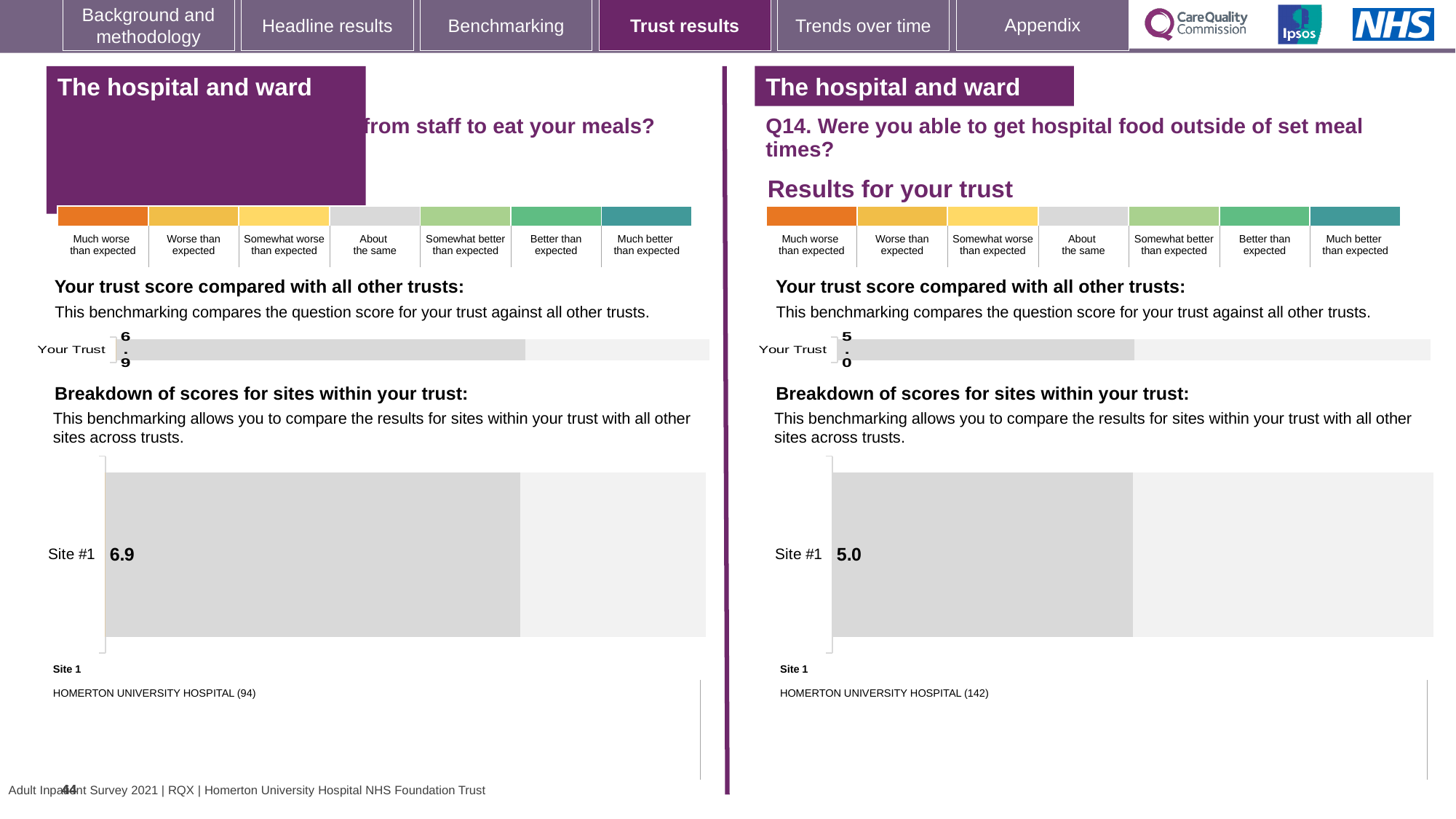
On the right-hand chart for Q14 (hospital food outside of set meal times), what is the score shown for Your Trust? 5.0 How many sites are shown in the right-hand 'Breakdown of scores for sites within your trust' chart for Q14? 1 How many sites are shown in the left-hand 'Breakdown of scores for sites within your trust' chart? 1 Which is larger: the Your Trust score on the left-hand chart or the Your Trust score on the right-hand Q14 chart? The left-hand chart (6.9) In the left-hand 'Breakdown of scores for sites within your trust' chart, what is the score for Site #1? 6.9 Which hospital is listed as Site 1 beneath the left-hand site breakdown chart? HOMERTON UNIVERSITY HOSPITAL (94) Which hospital is listed as Site 1 beneath the right-hand Q14 site breakdown chart? HOMERTON UNIVERSITY HOSPITAL (142) What type of chart is used in the left-hand 'Breakdown of scores for sites within your trust' section? Bar chart In the right-hand 'Breakdown of scores for sites within your trust' chart for Q14, what is the score for Site #1? 5.0 What type of chart is used to show the Your Trust score on the right-hand Q14 section? Bar chart On the left-hand chart (question about help from staff to eat your meals), what is the score shown for Your Trust? 6.9 What is the difference between the Site #1 score on the left-hand chart and the Site #1 score on the right-hand Q14 chart? 1.9